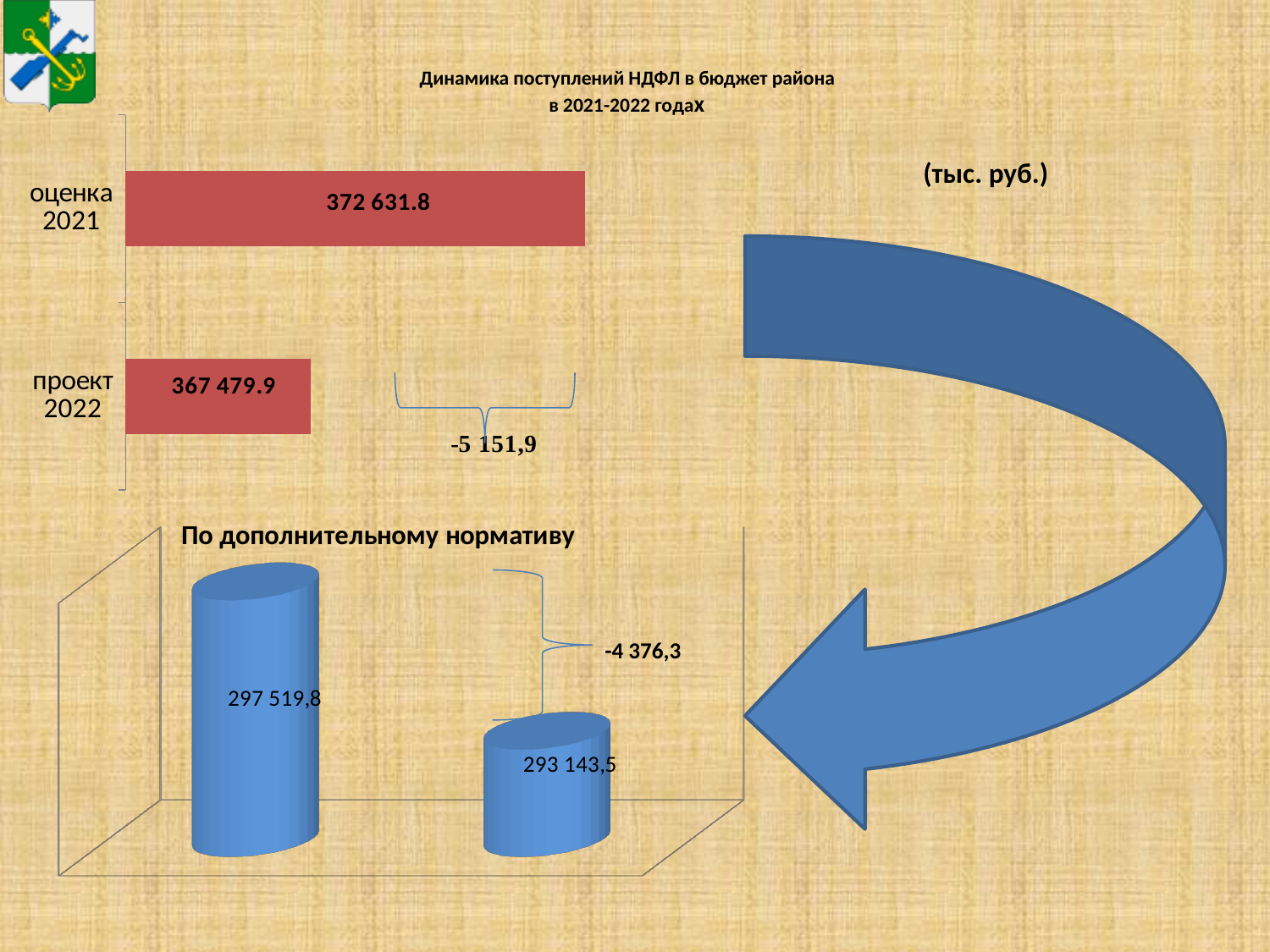
In the bottom chart 'По дополнительному нормативу', is the left bar or the right bar larger? left bar In the top chart 'Динамика поступлений НДФЛ в бюджет района в 2021-2022 годах', which category has the lower value? проект 2022 In the bottom chart 'По дополнительному нормативу', what is the value of the right bar? 293 143,5 In the top chart 'Динамика поступлений НДФЛ в бюджет района в 2021-2022 годах', what is the difference between 'оценка 2021' and 'проект 2022' as annotated on the slide? -5 151,9 In the top chart 'Динамика поступлений НДФЛ в бюджет района в 2021-2022 годах', what is the value for 'оценка 2021'? 372 631.8 In the bottom chart 'По дополнительному нормативу', what is the value of the left bar? 297 519,8 In the top chart 'Динамика поступлений НДФЛ в бюджет района в 2021-2022 годах', what is the value for 'проект 2022'? 367 479.9 What kind of chart is the top chart 'Динамика поступлений НДФЛ в бюджет района в 2021-2022 годах'? bar chart In the bottom chart 'По дополнительному нормативу', what is the difference between the two bars as annotated on the slide? -4 376,3 In the top chart 'Динамика поступлений НДФЛ в бюджет района в 2021-2022 годах', which category has the higher value? оценка 2021 In the top chart 'Динамика поступлений НДФЛ в бюджет района в 2021-2022 годах', how many categories are shown? 2 In the top chart 'Динамика поступлений НДФЛ в бюджет района в 2021-2022 годах', what unit is indicated for the values? тыс. руб.